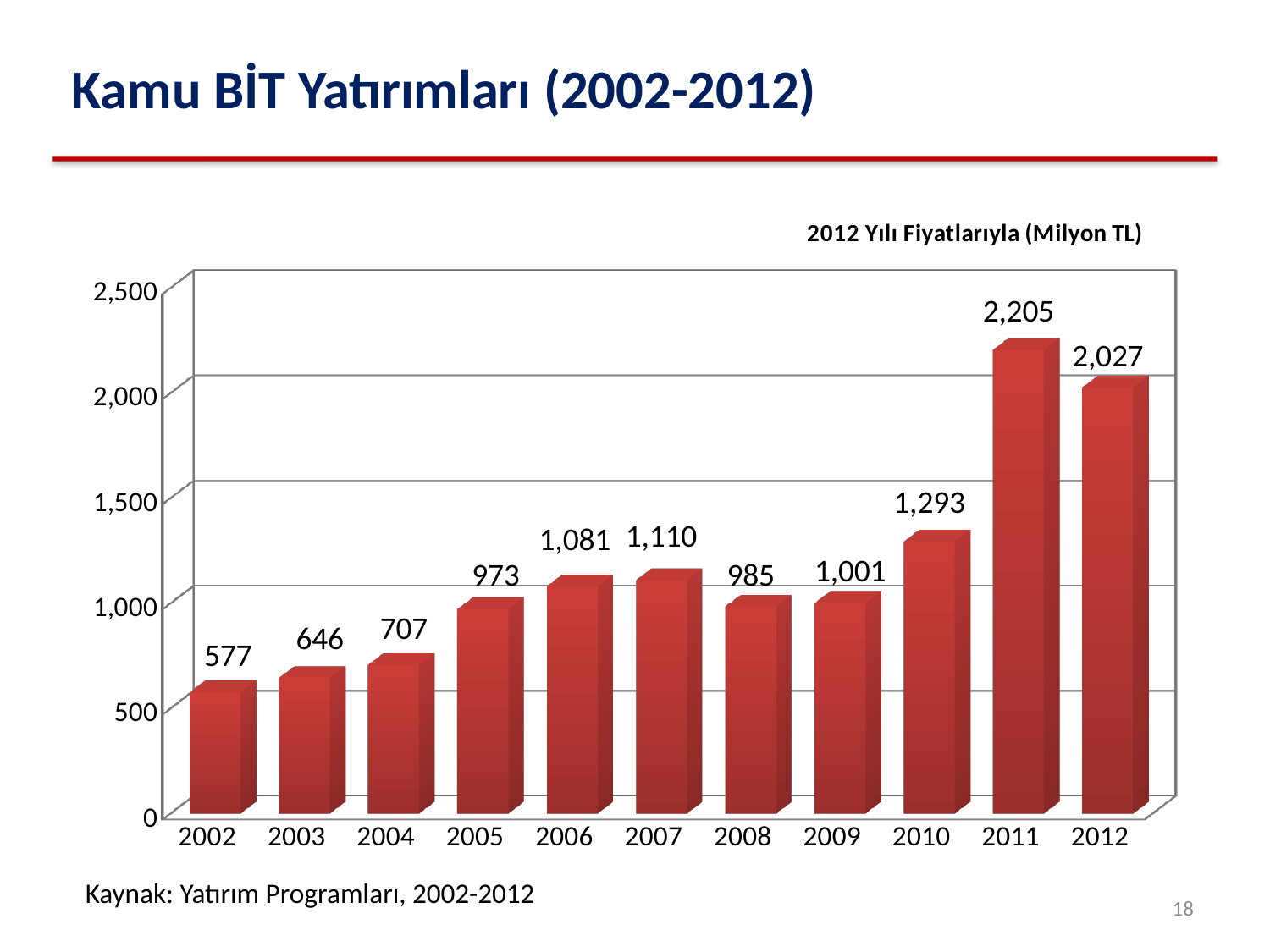
Which year has the highest value? 2011 What is the value for 2002? 577 What is the difference between the values for 2011 and 2012? 178 Which is larger, the value for 2008 or the value for 2009? 2009 Is the value for 2005 greater or less than 1,000? less What is the value for 2010? 1,293 What kind of chart is shown on the slide? bar chart How many years are shown on the x axis? 11 Which year has the lowest value? 2002 What is the difference between the values for 2003 and 2002? 69 What is the value for 2007? 1,110 What unit is stated in the label above the chart? Milyon TL